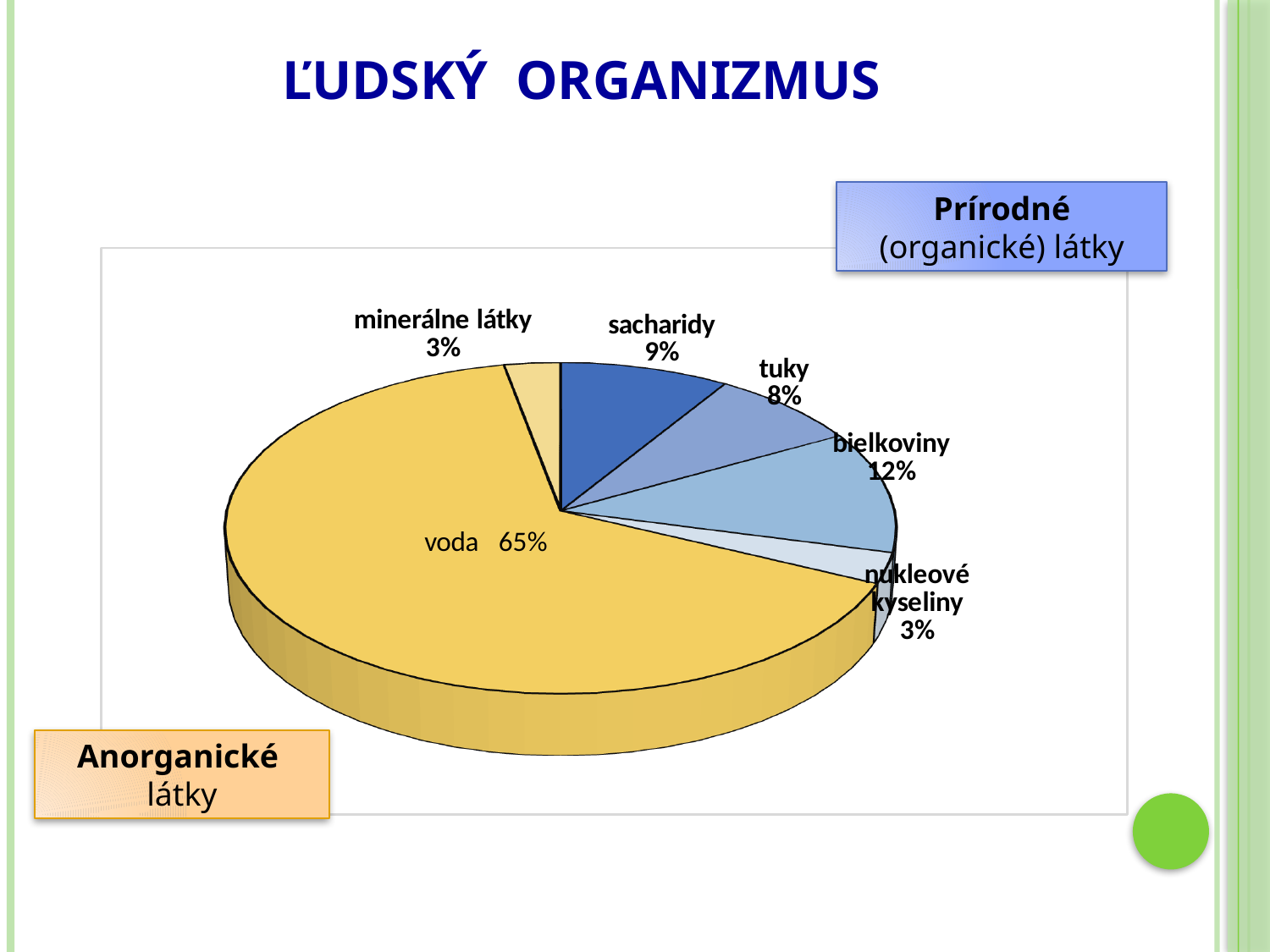
What is the value shown for bielkoviny? 12% Which slice of the pie is the largest? voda How many slices does the pie chart have? 6 What is the value shown for sacharidy? 9% What is the difference between the values for sacharidy and tuky? 1% Which is larger, bielkoviny or sacharidy? bielkoviny What is the value shown for nukleové kyseliny? 3% What kind of chart is shown on the slide? pie chart What is the title of the slide containing the pie chart? ĽUDSKÝ ORGANIZMUS What is the value shown for tuky? 8% What is the difference between the values for voda and bielkoviny? 53% What percentage of the pie is labelled voda? 65%